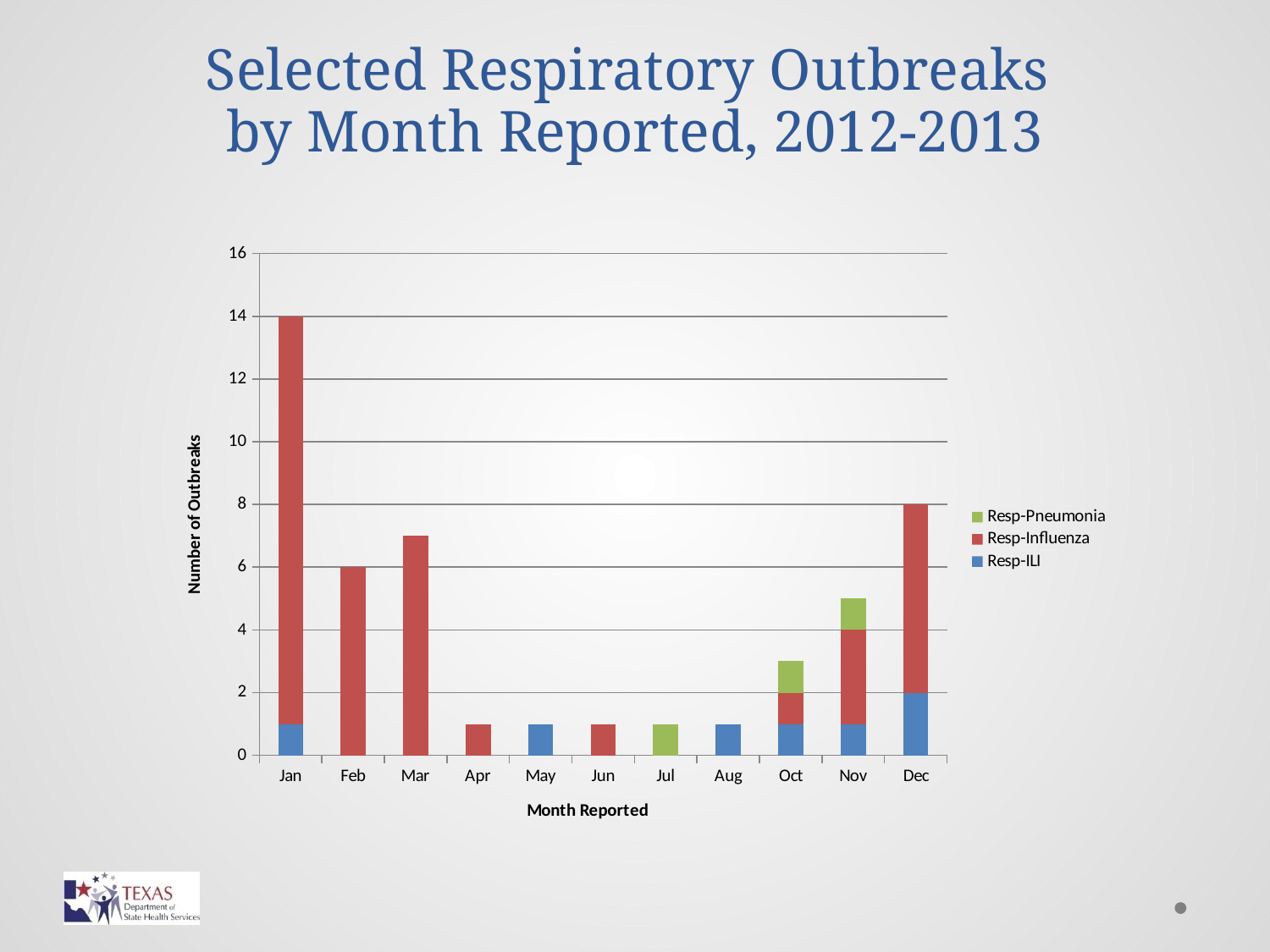
What is the total number of outbreaks reported in Jan? 14 Is the total number of outbreaks for Mar greater or less than 6? greater How many months are shown on the x axis? 11 What is the Resp-ILI value for Dec? 2 What is the total number of outbreaks reported in Dec? 8 How many series does the legend list? 3 What kind of chart is shown on the slide? Stacked bar chart What is the title of the y axis? Number of Outbreaks Is the total number of outbreaks for Nov greater or less than 4? greater What is the total number of outbreaks reported in Feb? 6 What is the difference between the total outbreaks in Jan and Feb? 8 Which month has the highest total number of outbreaks? Jan